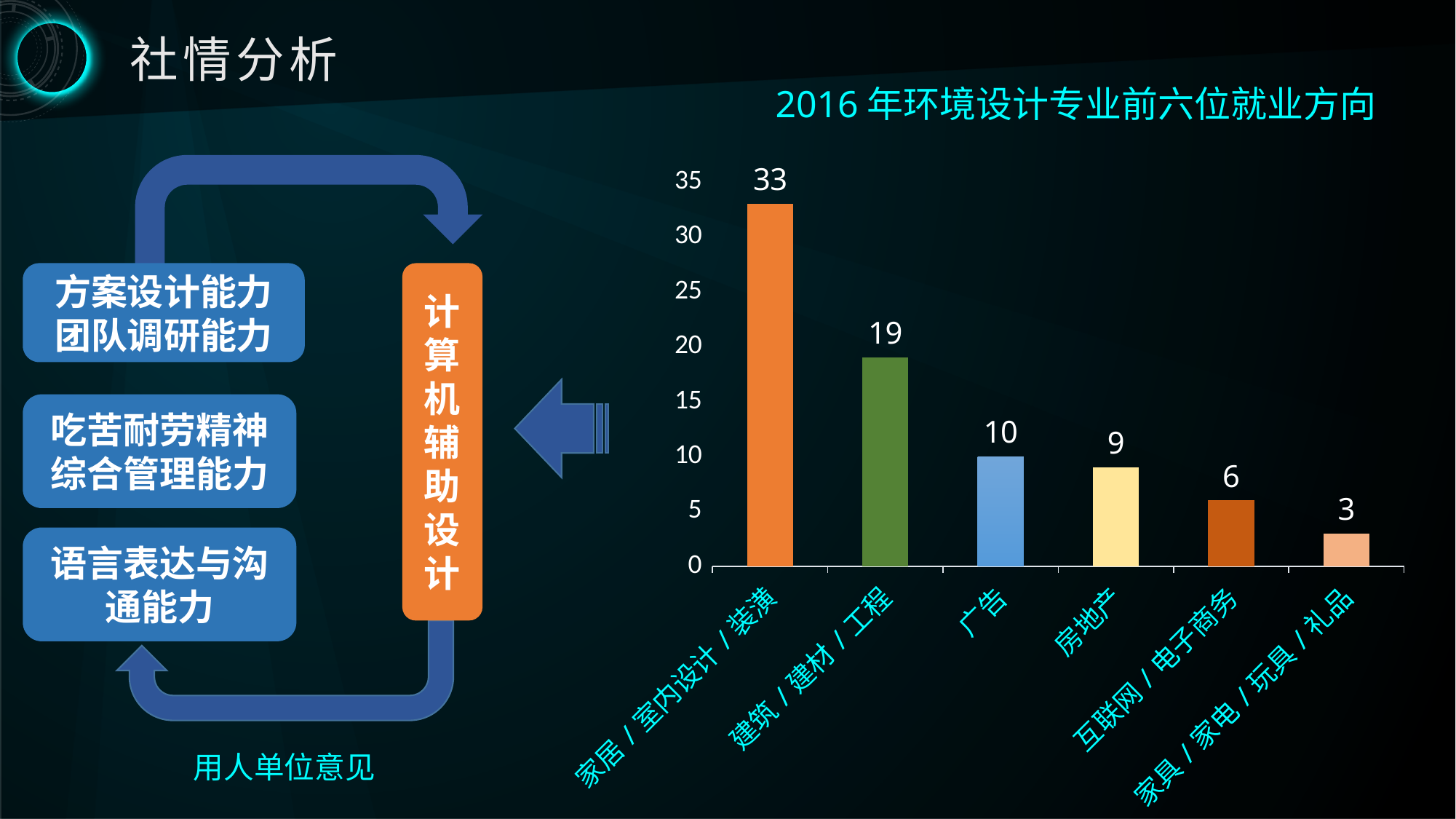
What is the value for 建筑 / 建材 / 工程? 19 What kind of chart is shown on the slide? bar chart Which is larger, the value for 广告 or the value for 互联网 / 电子商务? 广告 What is the value for 家具 / 家电 / 玩具 / 礼品? 3 What is the difference between the values for 家居 / 室内设计 / 装潢 and 建筑 / 建材 / 工程? 14 Which category has the lowest value? 家具 / 家电 / 玩具 / 礼品 How many categories are shown in the chart? 6 Is the value for 建筑 / 建材 / 工程 greater or less than 15? greater Which category has the highest value? 家居 / 室内设计 / 装潢 What is the value for 家居 / 室内设计 / 装潢? 33 What is the title of the chart? 2016 年环境设计专业前六位就业方向 What is the value for 房地产? 9